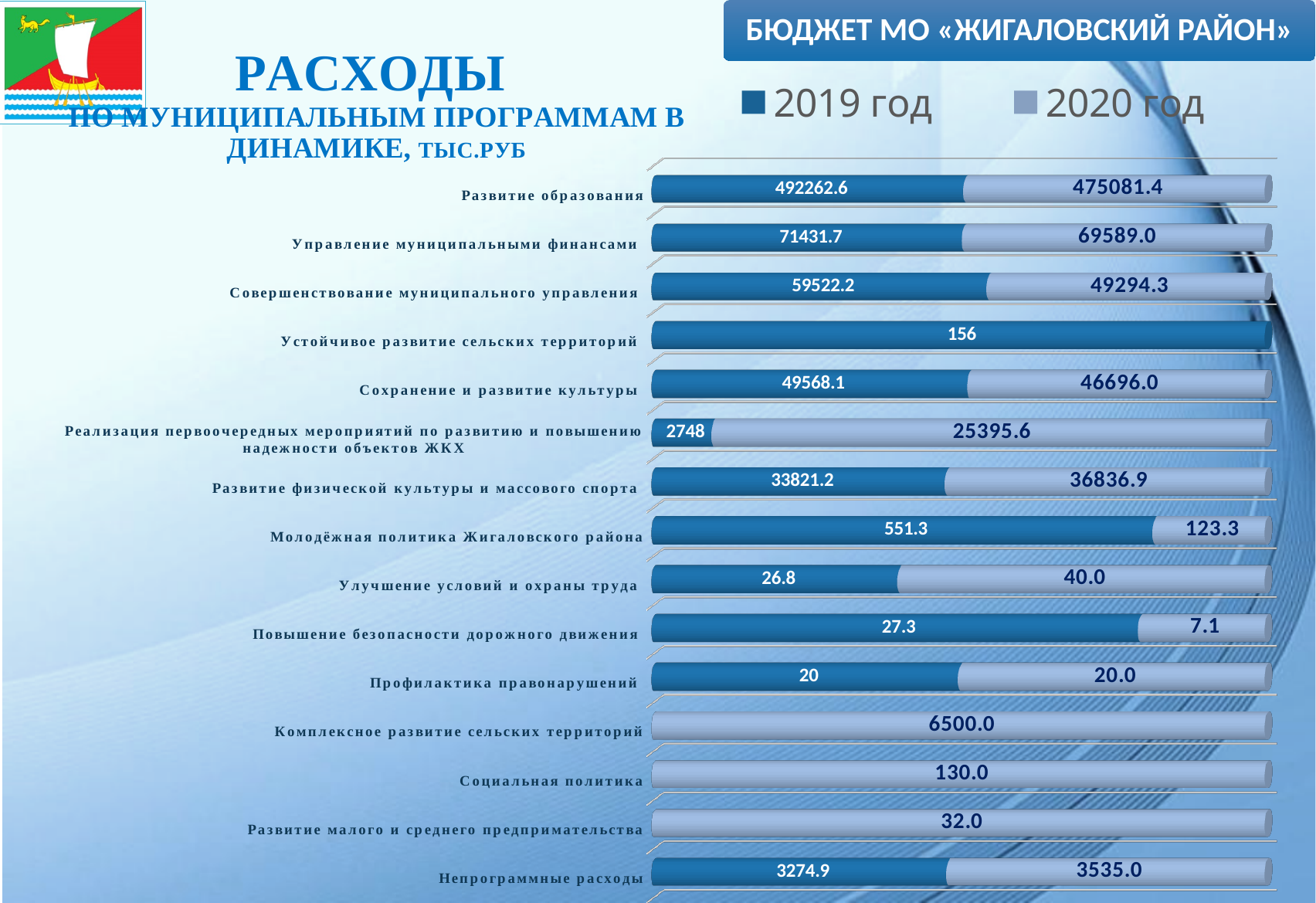
How many categories (programmes) are shown in the chart? 15 What is the difference between the 2019 год and 2020 год values for Развитие образования? 17181.2 Which category has the lowest 2020 год value among those with a 2020 год label? Повышение безопасности дорожного движения What kind of chart is shown on the slide? bar chart What are the two series named in the legend? 2019 год and 2020 год What is the 2019 год value for Молодёжная политика Жигаловского района? 551.3 What is the 2020 год value for Сохранение и развитие культуры? 46696.0 What is the 2020 год value for Реализация первоочередных мероприятий по развитию и повышению надежности объектов ЖКХ? 25395.6 For Улучшение условий и охраны труда, which is larger: the 2019 год value or the 2020 год value? 2020 год Which category has the highest 2019 год value? Развитие образования What is the 2019 год value for Развитие образования? 492262.6 How many series does the legend list? 2